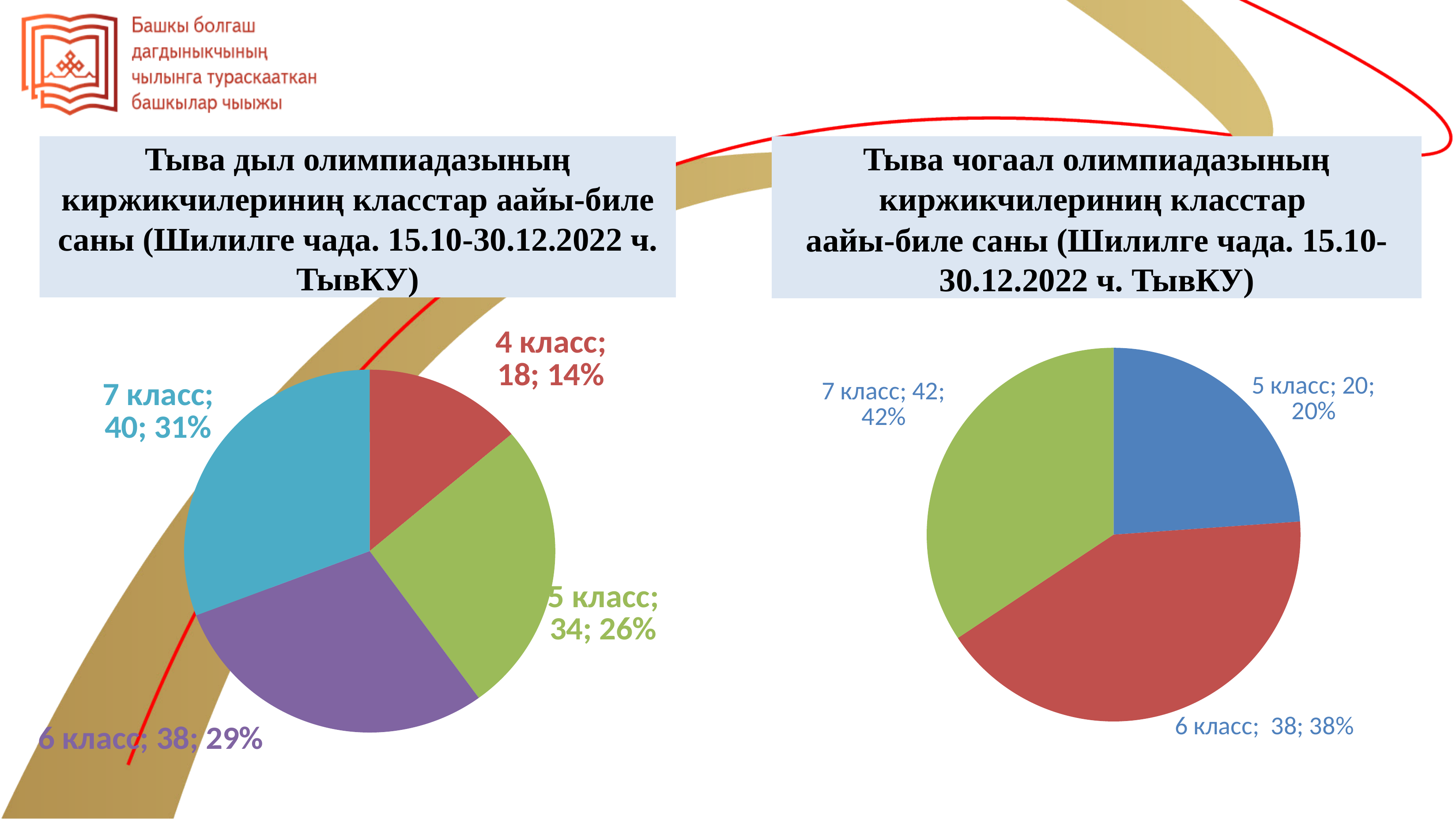
What kind of chart is the left chart (Тыва дыл олимпиадазының)? pie chart In the left chart (Тыва дыл олимпиадазының), which class has the smallest slice? 4 класс In the right chart (Тыва чогаал олимпиадазының), which class has the smallest slice? 5 класс In the left chart (Тыва дыл олимпиадазының), what is the difference between the values for 6 класс and 5 класс? 4 In the left chart (Тыва дыл олимпиадазының), what share of the pie does 4 класс have? 14% How many slices does the left chart (Тыва дыл олимпиадазының) have? 4 How many slices does the right chart (Тыва чогаал олимпиадазының) have? 3 In the left chart (Тыва дыл олимпиадазының), what is the value for 7 класс? 40 In the left chart (Тыва дыл олимпиадазының), which class has the largest slice? 7 класс In the right chart (Тыва чогаал олимпиадазының), what share of the pie does 7 класс have? 42% In the right chart (Тыва чогаал олимпиадазының), what is the value for 6 класс? 38